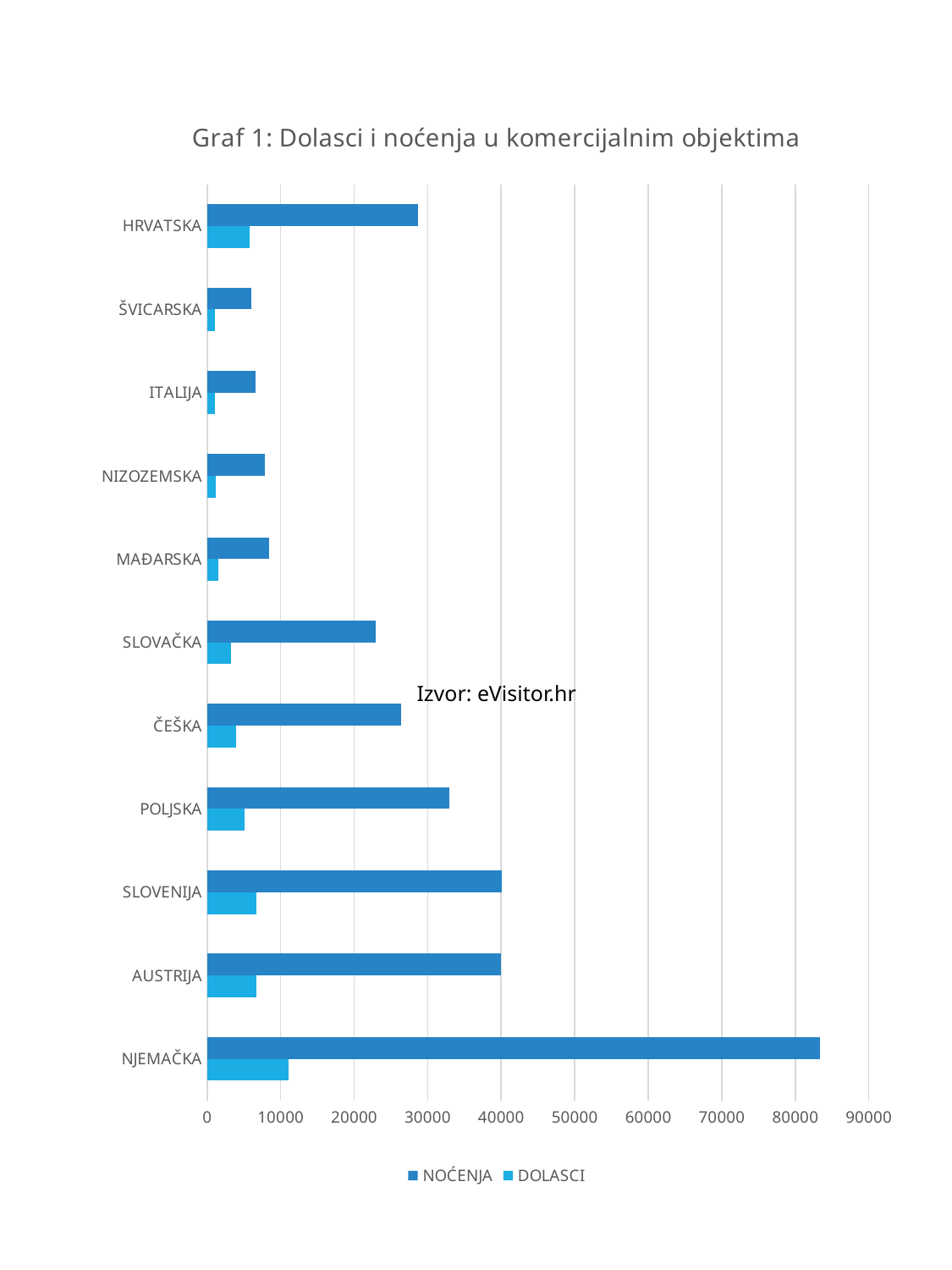
Which country has the highest value for DOLASCI? NJEMAČKA Is the NOĆENJA value for NJEMAČKA greater or less than 80000? greater Is the NOĆENJA value for MAĐARSKA greater or less than 10000? less How many series does the legend list? 2 Is the NOĆENJA value for ČEŠKA greater or less than 20000? greater What is the title of the chart? Graf 1: Dolasci i noćenja u komercijalnim objektima What kind of chart is shown on the slide? bar chart Which has the larger NOĆENJA value, NJEMAČKA or AUSTRIJA? NJEMAČKA Which country has the highest value for NOĆENJA? NJEMAČKA How many countries are shown on the chart? 11 Which has the larger NOĆENJA value, POLJSKA or ČEŠKA? POLJSKA